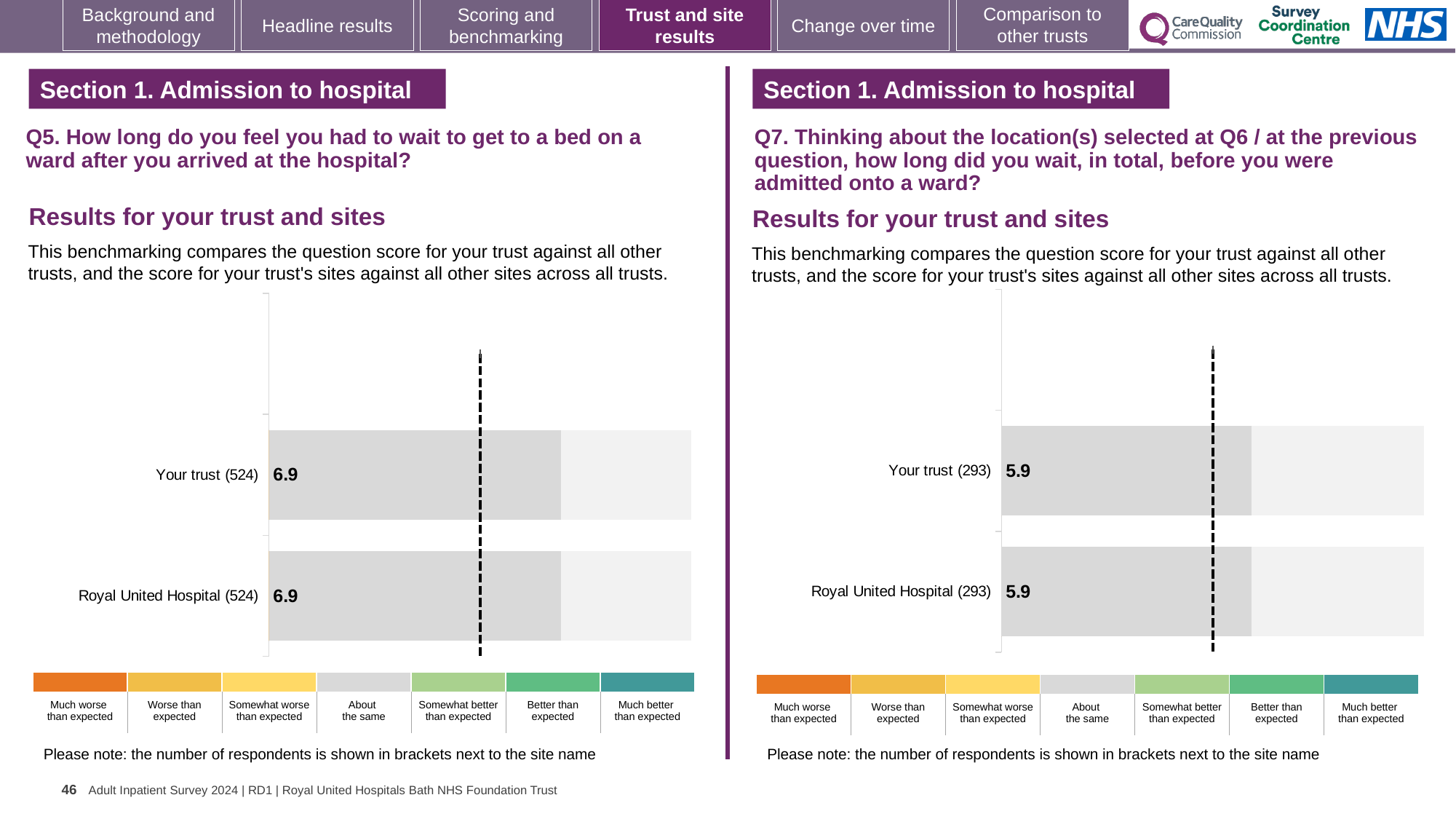
On the left chart (Q5), how many respondents are shown in brackets for Your trust? 524 On the left chart (Q5), what is the score for Royal United Hospital? 6.9 How many bars are plotted on the right chart (Q7)? 2 On the right chart (Q7), what is the score for Royal United Hospital? 5.9 On the left chart (Q5), what is the score for Your trust? 6.9 On the left chart (Q5), what is the difference between the score for Your trust and the score for Royal United Hospital? 0 What kind of chart is used on the left (Q5)? Bar chart Is the score for Your trust on the left chart (Q5) larger or smaller than the score for Your trust on the right chart (Q7)? Larger On the right chart (Q7), what is the difference between the score for Your trust and the score for Royal United Hospital? 0 How many bars are plotted on the left chart (Q5)? 2 On the right chart (Q7), what is the score for Your trust? 5.9 On the right chart (Q7), how many respondents are shown in brackets for Royal United Hospital? 293